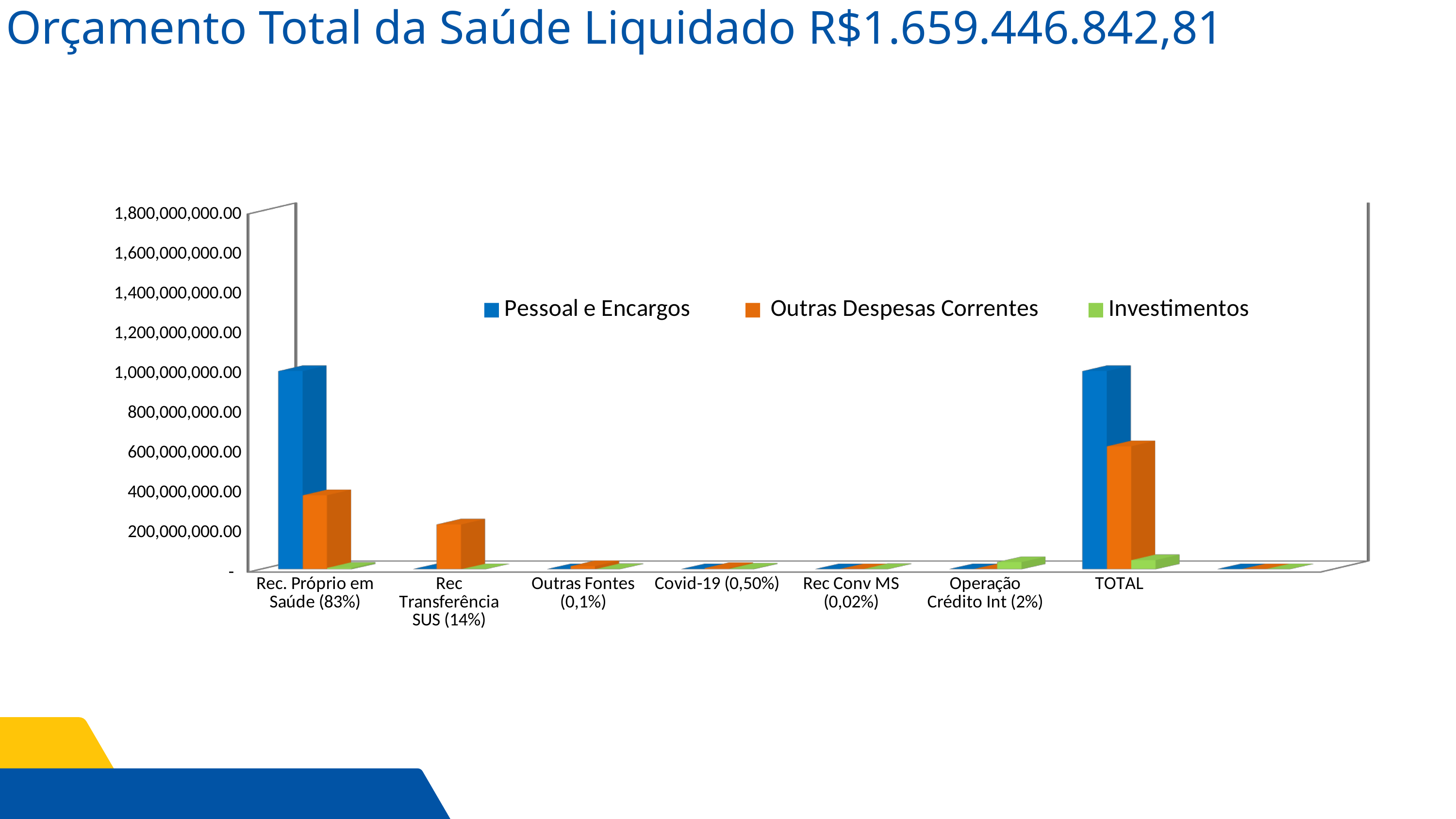
What total amount is stated in the slide title? R$1.659.446.842,81 Which series has the tallest bar for Rec. Próprio em Saúde (83%)? Pessoal e Encargos For TOTAL, which is larger: Pessoal e Encargos or Outras Despesas Correntes? Pessoal e Encargos What kind of chart is shown on the slide? Bar chart Which has the larger Outras Despesas Correntes value: Rec. Próprio em Saúde (83%) or Rec Transferência SUS (14%)? Rec. Próprio em Saúde (83%) Is the Outras Despesas Correntes value for Rec. Próprio em Saúde (83%) greater or less than 600,000,000.00? less Is the Outras Despesas Correntes value for Rec Transferência SUS (14%) greater or less than 400,000,000.00? less Is the Outras Despesas Correntes value for TOTAL greater or less than 400,000,000.00? greater How many series does the legend list? 3 How many categories are shown along the x axis? 7 What colour represents the Investimentos series in the legend? Green